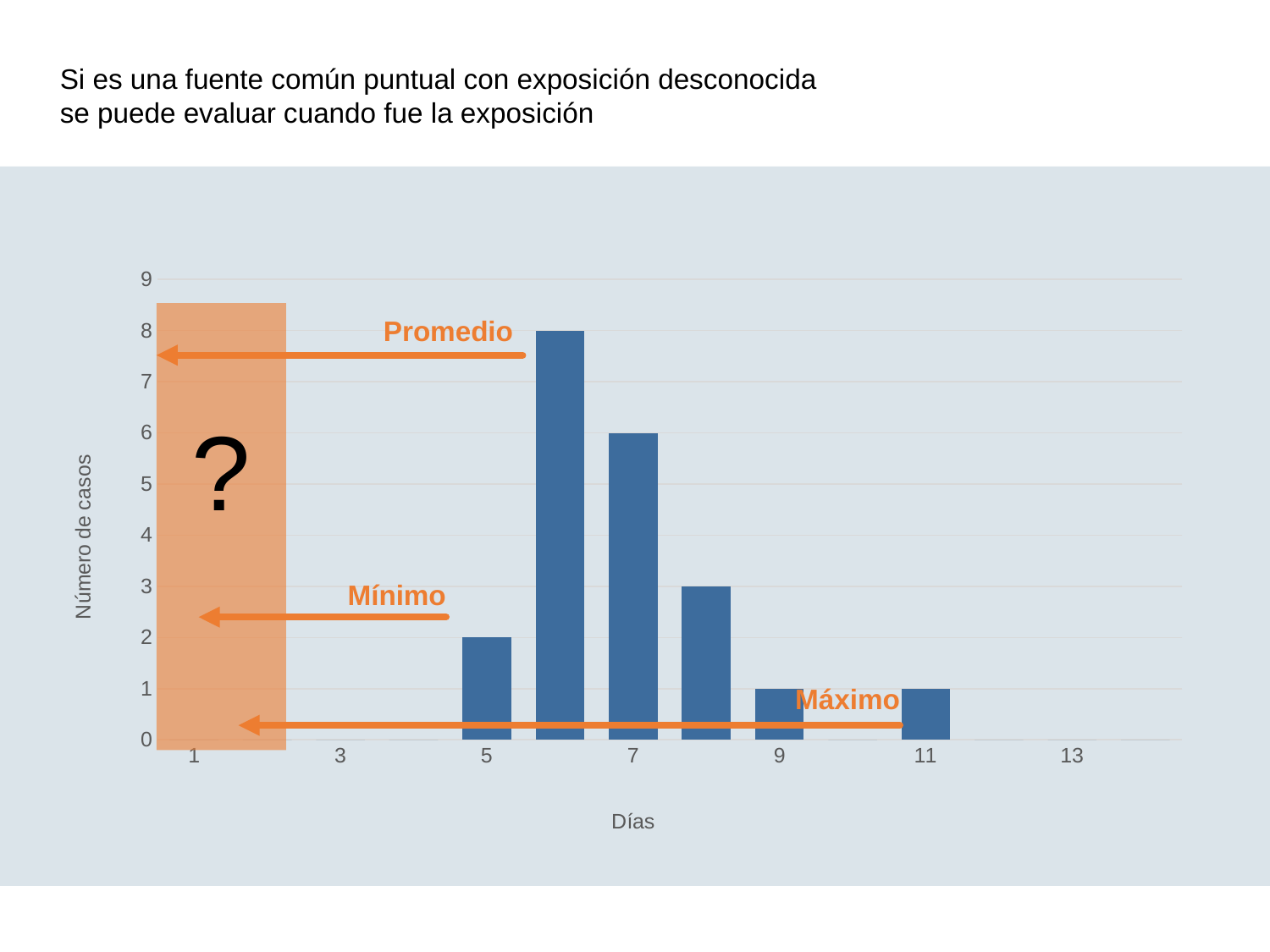
How many cases are shown for day 9? 1 Do the number of cases rise or fall from day 7 to day 9? fall What is the difference in cases between day 7 and day 5? 4 How many cases are shown for day 11? 1 How many cases are shown for day 5? 2 What is the number of cases shown by the tallest bar? 8 What is the label of the y axis? Número de casos How many cases are shown for day 7? 6 How many bars are plotted in the chart? 6 What is the label of the x axis? Días What type of chart is shown on the slide? bar chart Which has more cases, day 7 or day 9? day 7